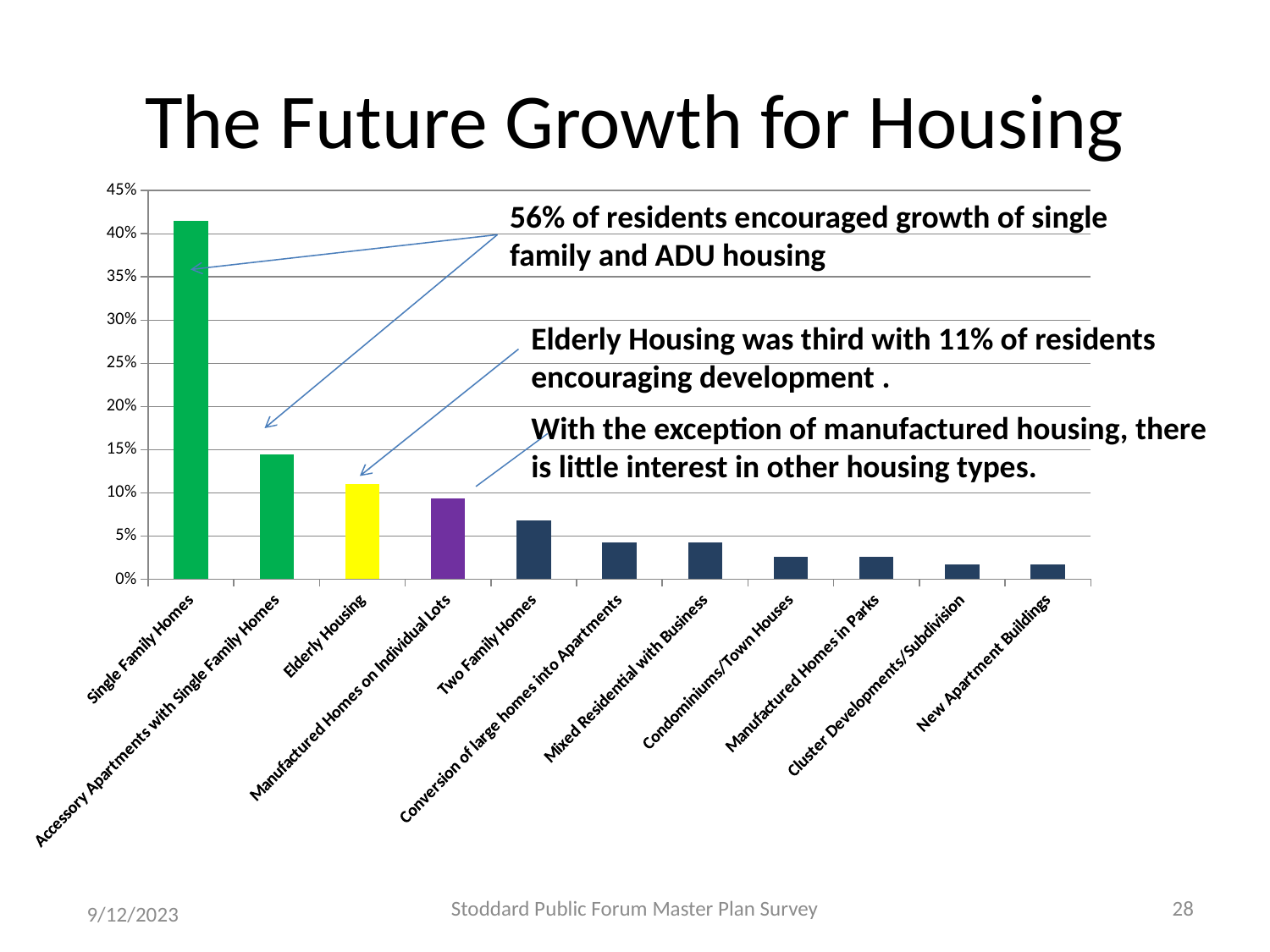
Do the bar values generally rise or fall moving from left to right along the x axis? fall Which housing category has the highest value on the chart? Single Family Homes Is the value for Accessory Apartments with Single Family Homes greater or less than 10%? greater Is the value for Single Family Homes greater or less than 35%? greater What type of chart is shown on the slide? bar chart Is the value for Cluster Developments/Subdivision greater or less than 5%? less How many housing categories are plotted on the chart? 11 What colour is the bar for Elderly Housing? yellow According to the slide, what percentage of residents encouraged development of Elderly Housing? 11% Which is larger, the value for Single Family Homes or the value for Accessory Apartments with Single Family Homes? Single Family Homes Which is larger, the value for Elderly Housing or the value for Two Family Homes? Elderly Housing